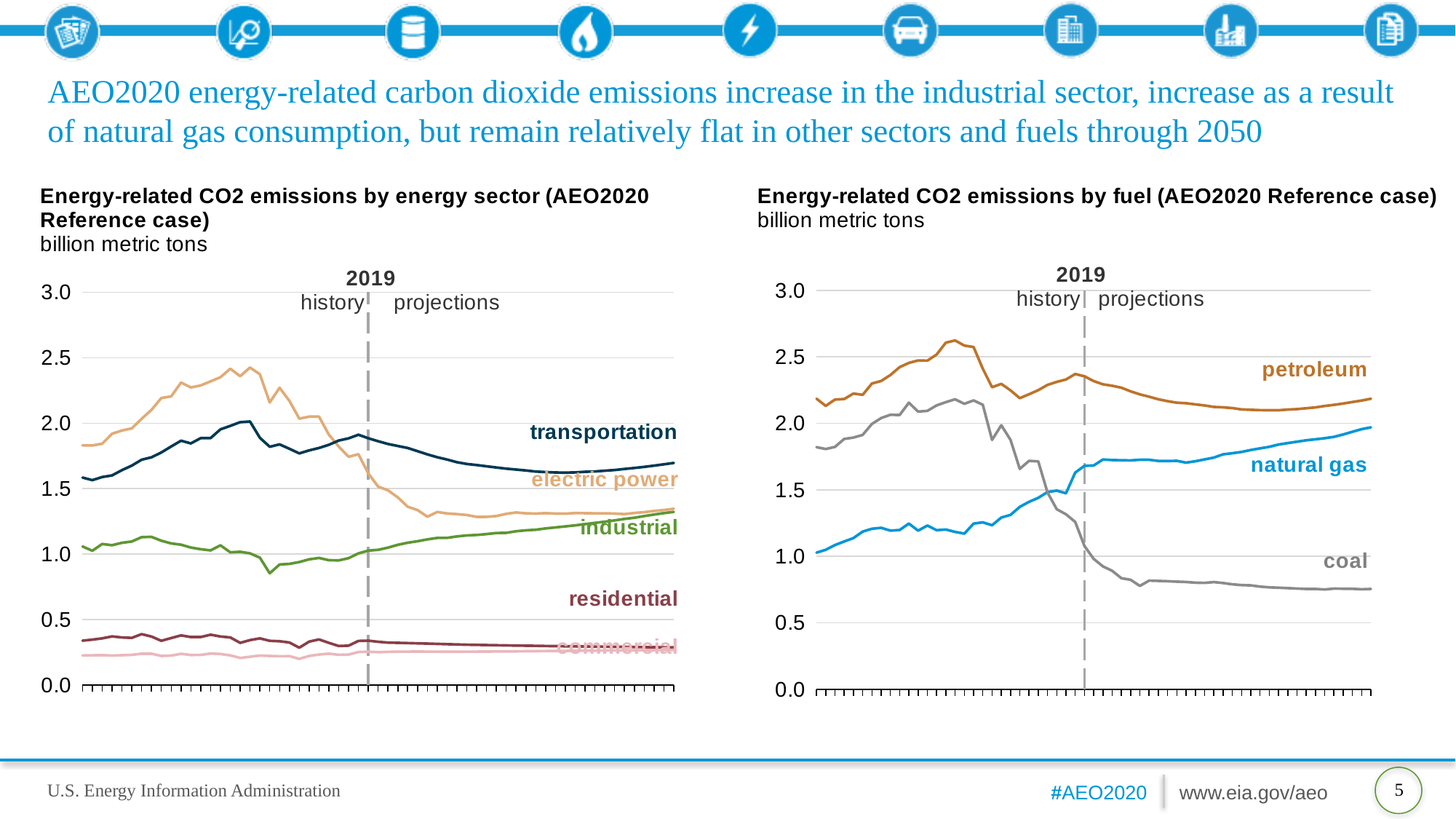
In the left chart (emissions by energy sector), which sector has the highest emissions at the end of the projection period? transportation In the right chart (emissions by fuel), which fuel has the lowest emissions at the end of the projection period? coal What kind of chart is the left chart, 'Energy-related CO2 emissions by energy sector'? line chart In the right chart (emissions by fuel), is the value for coal at the end of the projection period greater or less than 1.0? less In the left chart (emissions by energy sector), which sector has the lowest emissions throughout the chart? commercial What year marks the boundary between history and projections in both charts? 2019 In the right chart (emissions by fuel), how many fuel series are plotted? 3 In the left chart (emissions by energy sector), how many sector series are plotted? 5 In the left chart (emissions by energy sector), is the value for electric power at the end of the projection period greater or less than 1.5? less In the right chart (emissions by fuel), does the natural gas line rise or fall over the projection period? rise In the right chart (emissions by fuel), which fuel has the highest emissions at the end of the projection period? petroleum In the right chart (emissions by fuel), at the 2019 dividing line, which is larger: petroleum or natural gas? petroleum